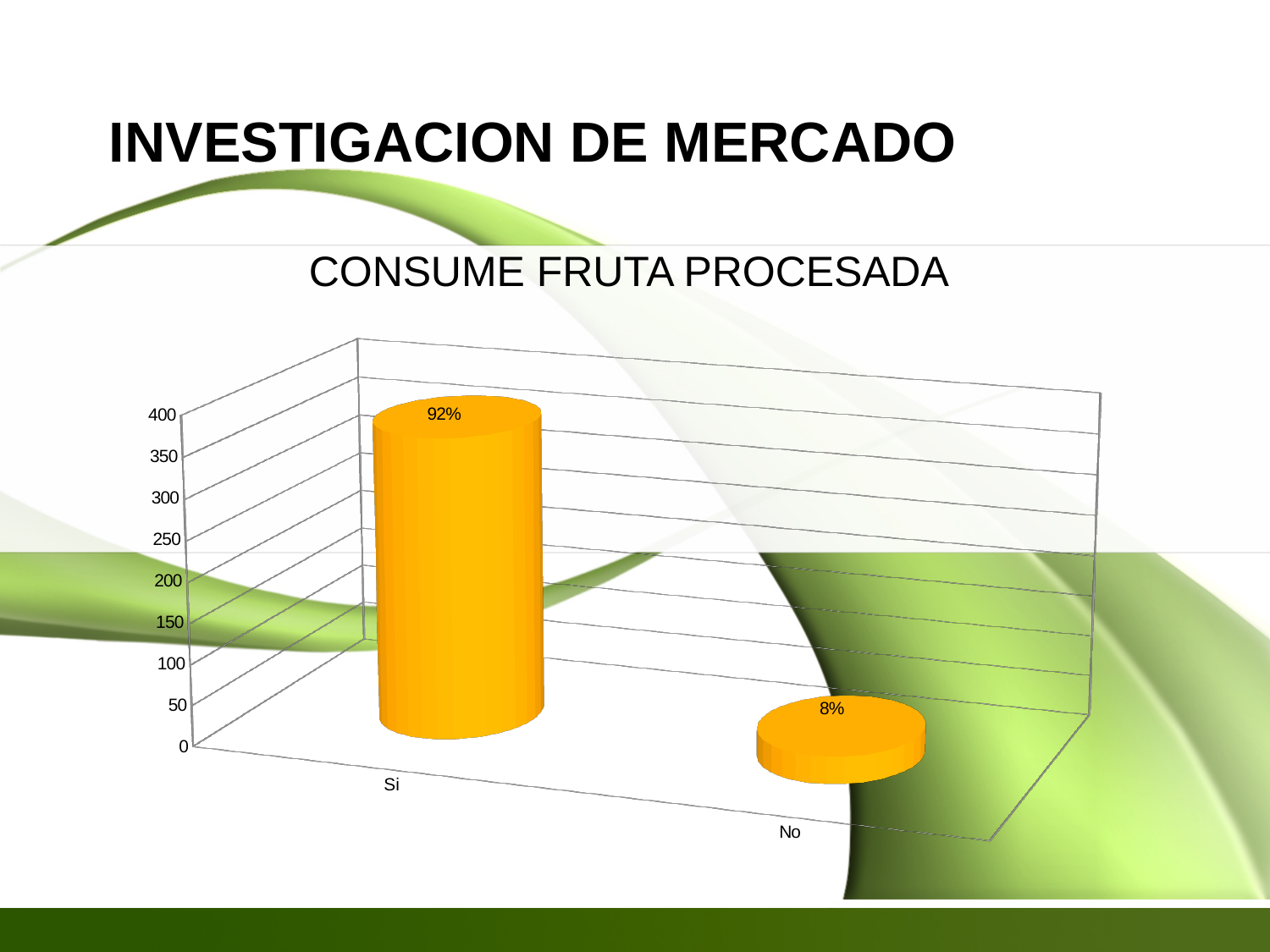
What is the title of the chart? CONSUME FRUTA PROCESADA What is the data label shown on the bar for "No"? 8% What is the data label shown on the bar for "Si"? 92% What kind of chart is shown on the slide? Bar chart How many categories are shown on the chart? 2 Which category has the highest value? Si Which is larger, the value for "Si" or the value for "No"? Si Is the bar for "Si" greater or less than 200 on the vertical axis? greater What is the highest value shown on the vertical axis of the chart? 400 Is the bar for "No" greater or less than 100 on the vertical axis? less What is the difference between the data labels for "Si" and "No"? 84% Which category has the lowest value? No